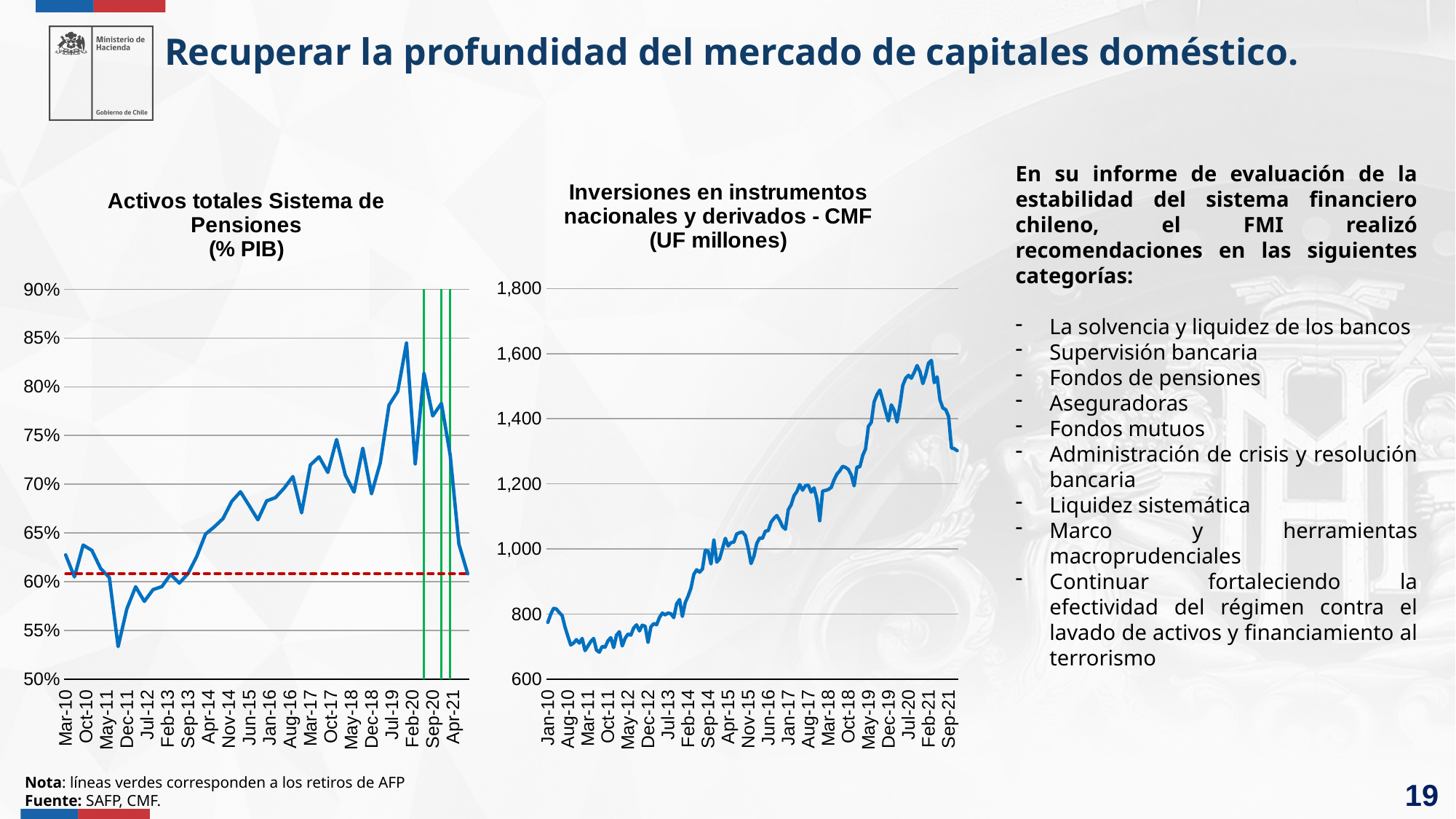
According to the note on the slide, what do the green lines on the left chart correspond to? los retiros de AFP In the left chart 'Activos totales Sistema de Pensiones (% PIB)', is the peak value reached around Jul-19 greater or less than 80%? greater In the left chart 'Activos totales Sistema de Pensiones (% PIB)', do values rise or fall between Feb-20 and Apr-21? fall How many green vertical lines are drawn on the left chart 'Activos totales Sistema de Pensiones (% PIB)'? 3 In the right chart 'Inversiones en instrumentos nacionales y derivados - CMF (UF millones)', do values generally rise or fall from Jan-10 to Feb-21? rise In the right chart 'Inversiones en instrumentos nacionales y derivados - CMF (UF millones)', is the last value at Sep-21 greater or less than 1,400? less What kind of chart is the right chart titled 'Inversiones en instrumentos nacionales y derivados - CMF (UF millones)'? line chart In the left chart 'Activos totales Sistema de Pensiones (% PIB)', is the last value at Apr-21 greater or less than 65%? less What kind of chart is the left chart titled 'Activos totales Sistema de Pensiones (% PIB)'? line chart